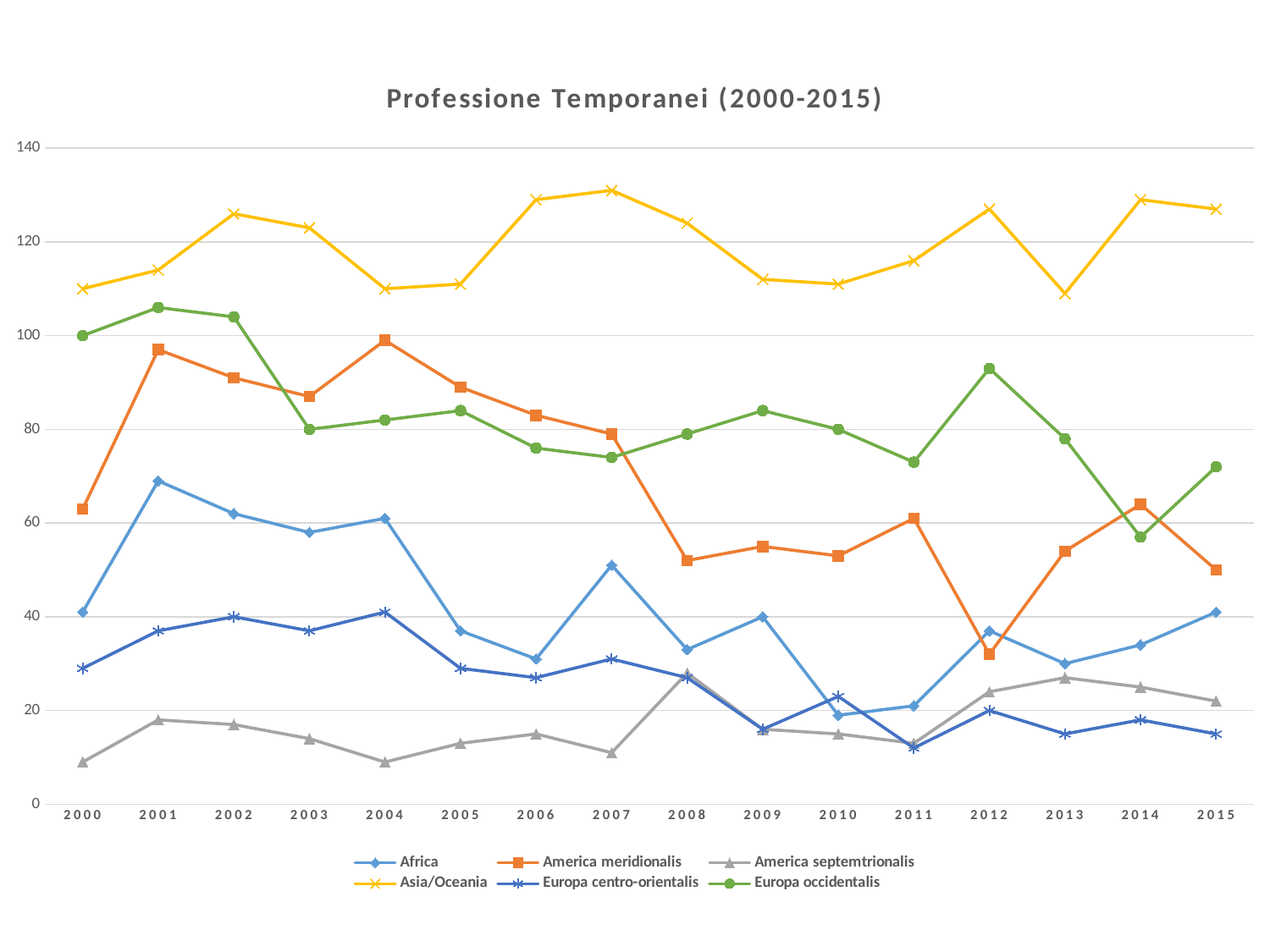
Does the value for America meridionalis rise or fall from 2004 to 2008? fall Is the value for Asia/Oceania in 2007 greater or less than 120? greater In which year does Europa occidentalis reach its lowest value? 2014 Is the value for America septemtrionalis in 2004 greater or less than 20? less In 2007, which is larger: Africa or Europa centro-orientalis? Africa How many series does the legend list? 6 In which year does America meridionalis reach its lowest value? 2012 In which year does Africa reach its highest value? 2001 What kind of chart is shown on the slide? line chart What is the title of the chart? Professione Temporanei (2000-2015) How many years are shown along the x axis? 16 Which series has the highest values across the whole period? Asia/Oceania